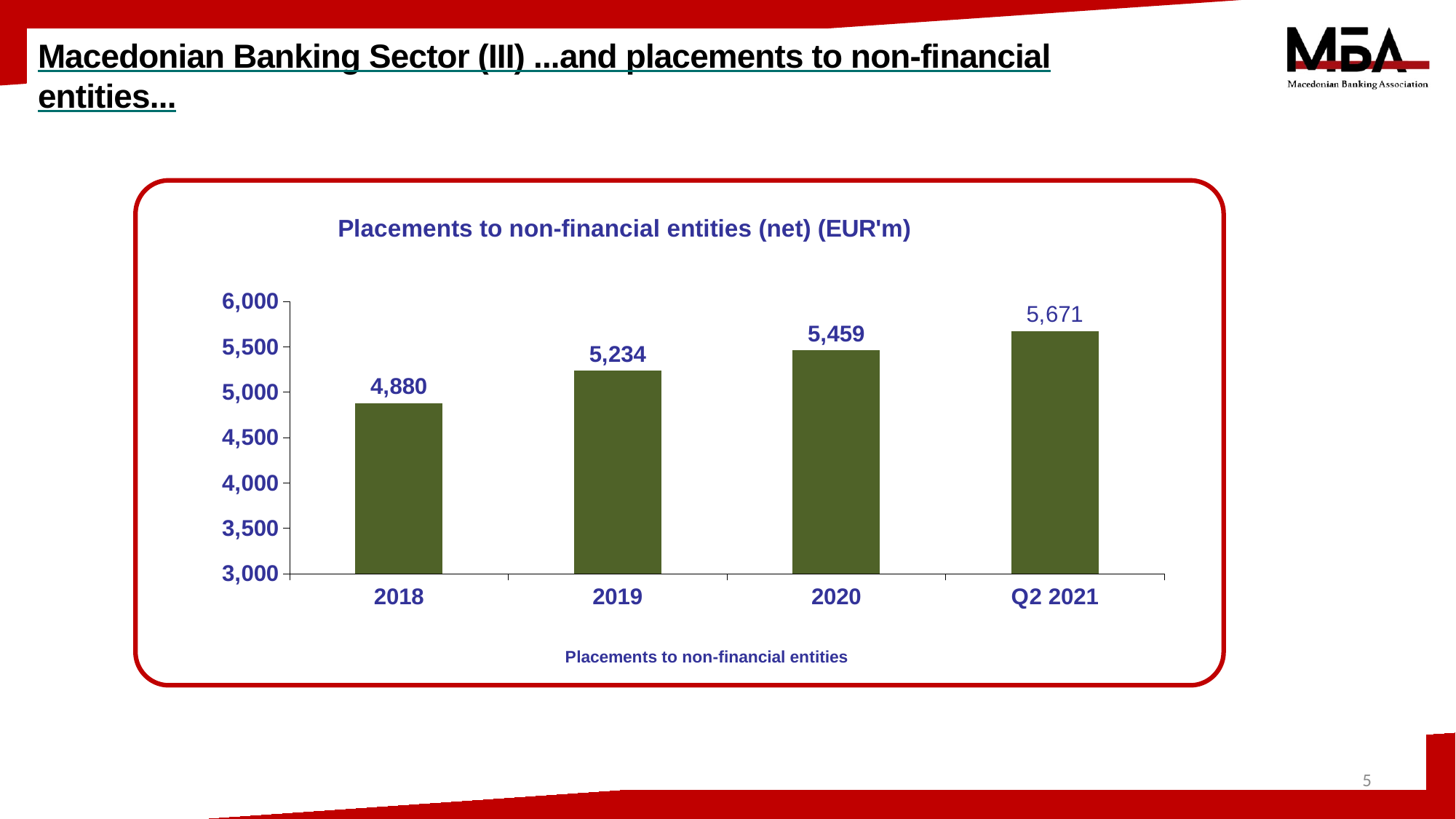
What is the value of placements to non-financial entities in Q2 2021? 5,671 How many periods are shown on the x axis of the chart? 4 What is the difference between the placements in Q2 2021 and in 2018? 791 What is the difference between the placements in 2020 and in 2019? 225 Do the values of placements to non-financial entities rise or fall from 2018 to Q2 2021? Rise What is the value of placements to non-financial entities in 2018? 4,880 What kind of chart is shown on the slide? Bar chart Which period has the highest value of placements to non-financial entities? Q2 2021 What is the value of placements to non-financial entities in 2020? 5,459 Which period has the lowest value of placements to non-financial entities? 2018 What is the value of placements to non-financial entities in 2019? 5,234 Which is larger, the placements in 2019 or in 2020? 2020